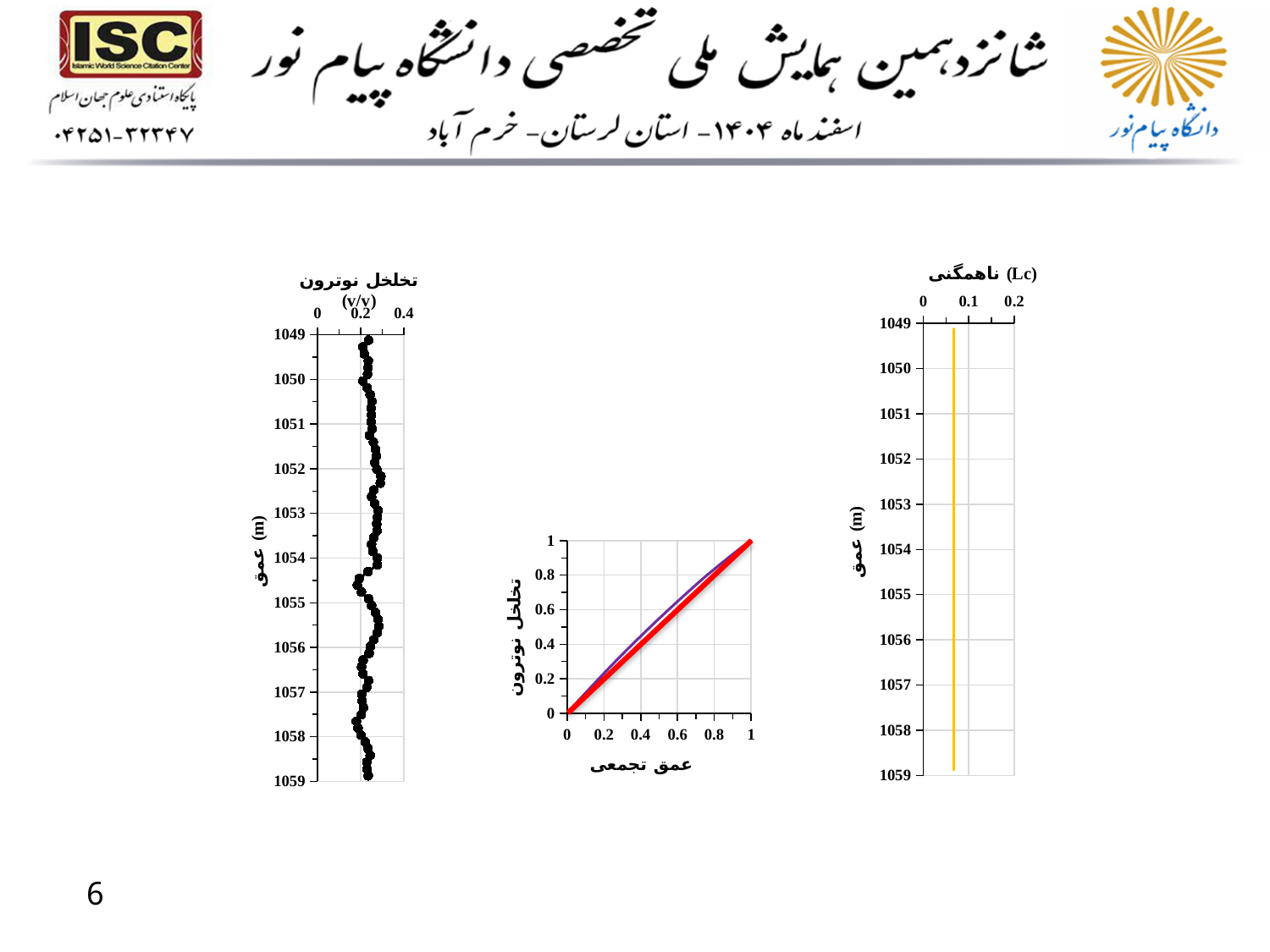
In the right chart (ناهمگنی (Lc)), does the plotted value change with depth, or stay constant? stays constant What is the x-axis title of the middle chart? عمق تجمعی How many labeled depth ticks are on the y axis of the left chart (from 1049 to 1059)? 11 In the right chart (ناهمگنی (Lc)), is the plotted Lc value greater or less than 0.1? less How many lines are plotted in the middle chart? 2 In the middle chart, do the plotted values rise or fall as cumulative depth increases from 0 to 1? rise In the middle chart, what is the neutron porosity value when cumulative depth is 0? 0 In the left chart (تخلخل نوترون (v/v)), is the neutron porosity at depth 1059 greater or less than 0.4? less What is the highest value shown on the x axis of the right chart (ناهمگنی (Lc))? 0.2 What kind of chart is the middle chart (neutron porosity versus cumulative depth)? line chart What kind of chart is the left chart (تخلخل نوترون (v/v) versus depth)? line chart In the middle chart, what is the neutron porosity value when cumulative depth is 1? 1